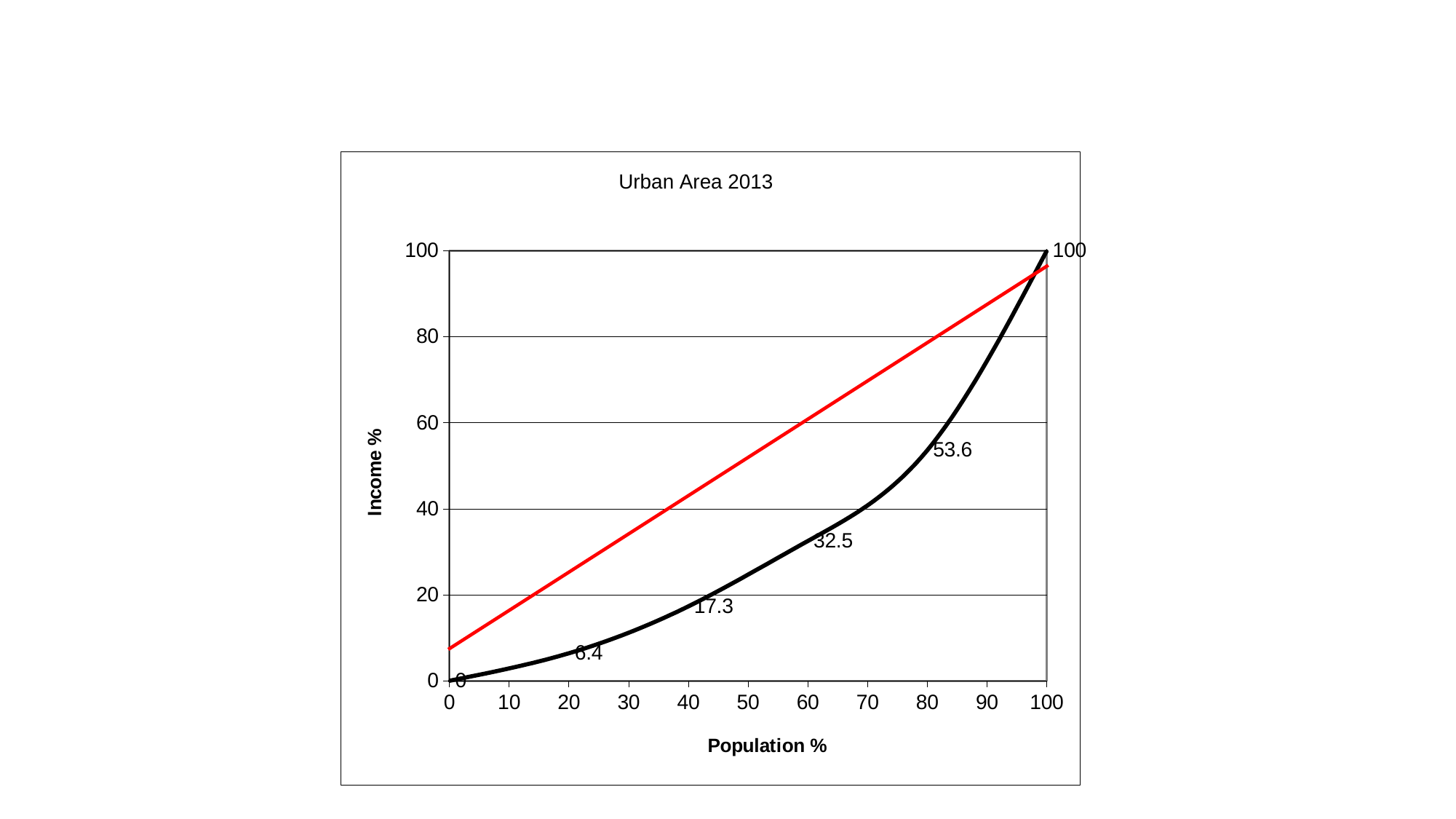
At 60% of the population, which is higher: the red line or the black curve? The red line What is the title of the chart? Urban Area 2013 What is the Income % value of the black curve at 60% of the population? 32.5 What is the Income % value of the black curve at 20% of the population? 6.4 Does the black curve rise or fall as Population % increases? Rises What is the difference between the Income % values at 40% and 20% of the population on the black curve? 10.9 What is the Income % value of the black curve at 40% of the population? 17.3 What kind of chart is shown on the slide? Line chart What is the Income % value of the black curve at 80% of the population? 53.6 What is the Income % value of the black curve at 100% of the population? 100 How many labelled data points are on the black curve? 6 What is the difference between the Income % values at 80% and 60% of the population on the black curve? 21.1